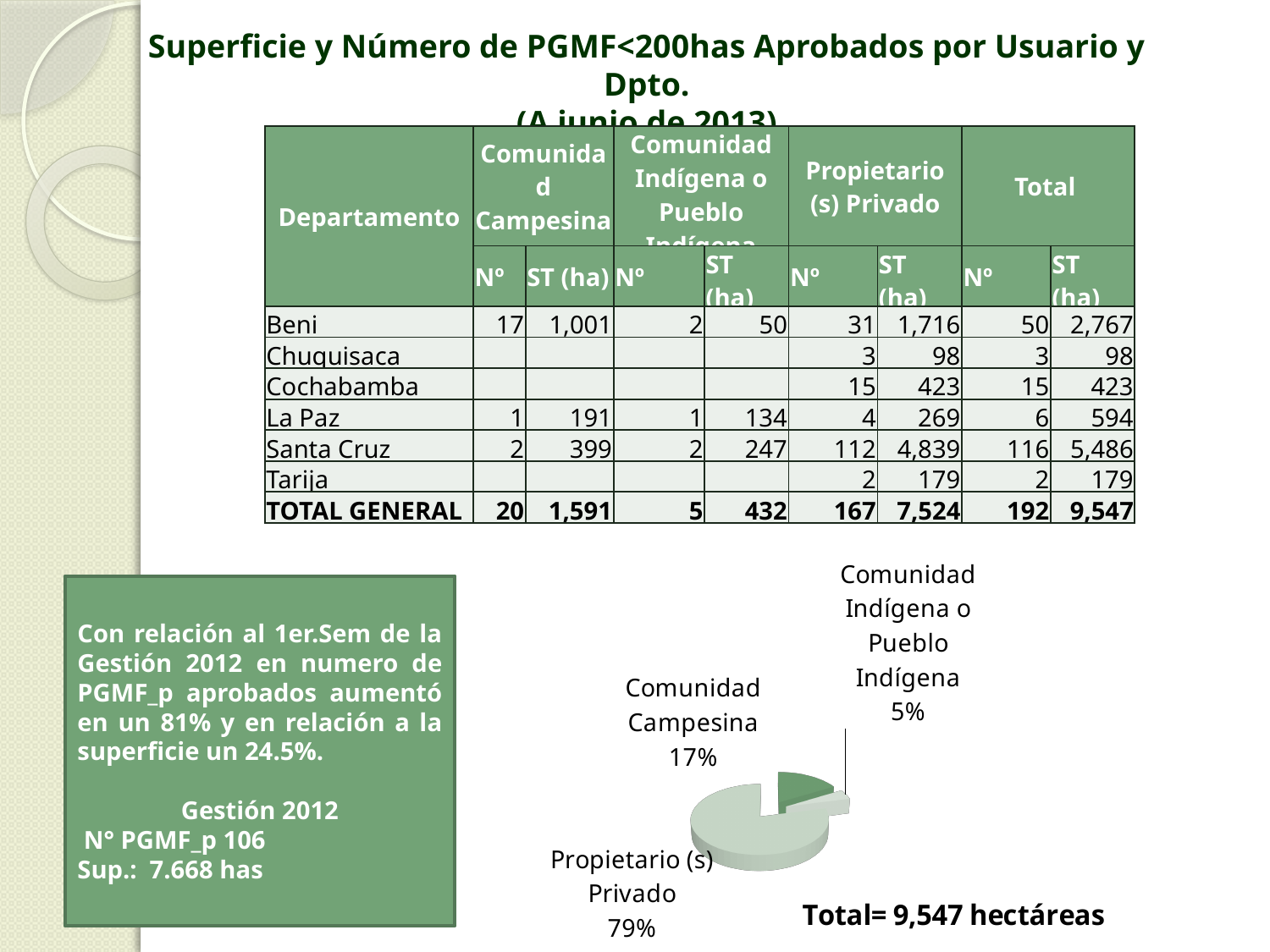
In the pie chart, what is the difference in percentage points between Propietario (s) Privado and Comunidad Campesina? 62 In the pie chart, which is larger: the share for Comunidad Campesina or the share for Comunidad Indígena o Pueblo Indígena? Comunidad Campesina How many slices does the pie chart have? 3 Which slice of the pie chart is the smallest? Comunidad Indígena o Pueblo Indígena Which slice of the pie chart is the largest? Propietario (s) Privado In the pie chart, what is the difference in percentage points between Comunidad Campesina and Comunidad Indígena o Pueblo Indígena? 12 What total in hectares is stated next to the pie chart? 9,547 hectáreas In the pie chart, what share does Propietario (s) Privado have? 79% In the pie chart, what share does Comunidad Indígena o Pueblo Indígena have? 5% In the pie chart, what share does Comunidad Campesina have? 17% What kind of chart is shown at the bottom right of the slide? pie chart Is the share for Propietario (s) Privado in the pie chart greater or less than 50%? greater